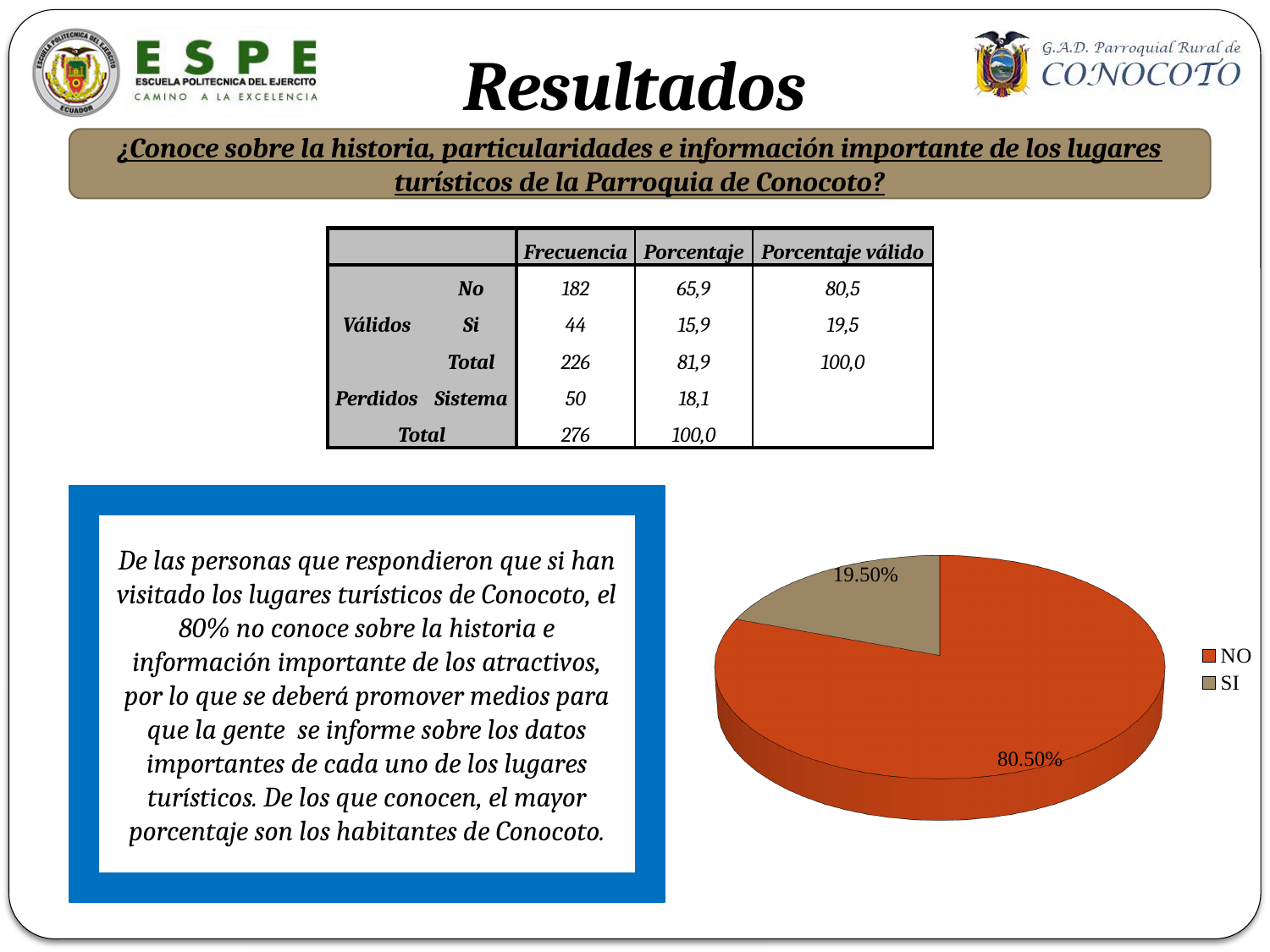
What is the difference between the NO and SI slices of the pie chart? 61.00% What kind of chart is shown on the slide? pie chart How many slices does the pie chart have? 2 What colour is the SI slice in the pie chart? tan/brown What is the value shown for the SI slice of the pie chart? 19.50% Which is larger in the pie chart, NO or SI? NO How many entries does the legend of the pie chart list? 2 What is the value shown for the NO slice of the pie chart? 80.50% What colour is the NO slice in the pie chart? orange-red What share of the pie does the SI slice represent? 19.50% Which slice of the pie chart is the smallest? SI Which slice of the pie chart is the largest? NO